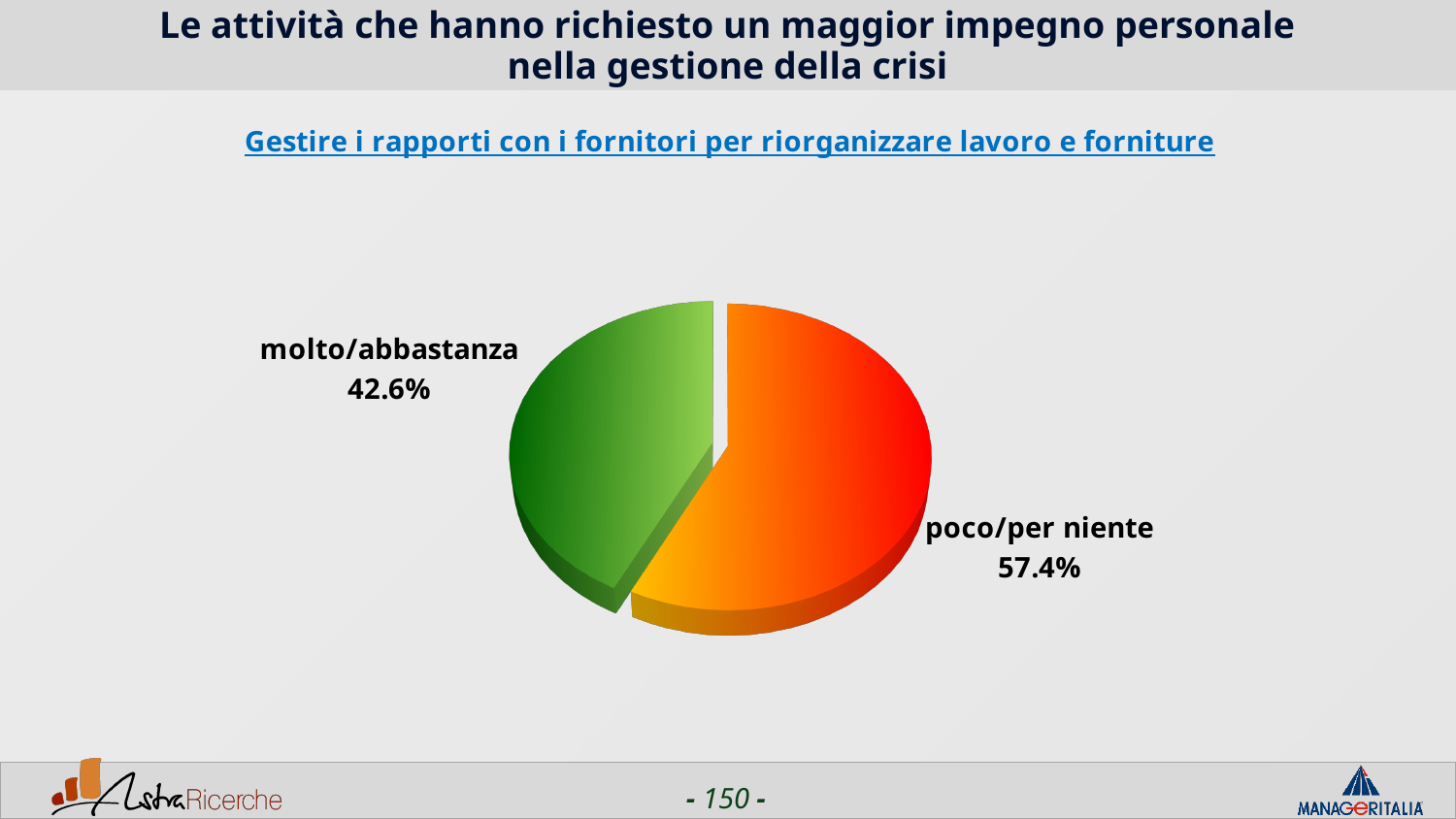
What is the value for "molto/abbastanza"? 42.6% What share of the pie does "molto/abbastanza" represent? 42.6% What is the subtitle above the pie chart? Gestire i rapporti con i fornitori per riorganizzare lavoro e forniture What colour is the "molto/abbastanza" slice? green What is the difference between the "poco/per niente" and "molto/abbastanza" slices? 14.8% Which slice is the smallest? molto/abbastanza How many slices does the pie chart have? 2 Which is larger, "molto/abbastanza" or "poco/per niente"? poco/per niente What kind of chart is shown on the slide? pie chart Which slice is the largest? poco/per niente What is the value for "poco/per niente"? 57.4%